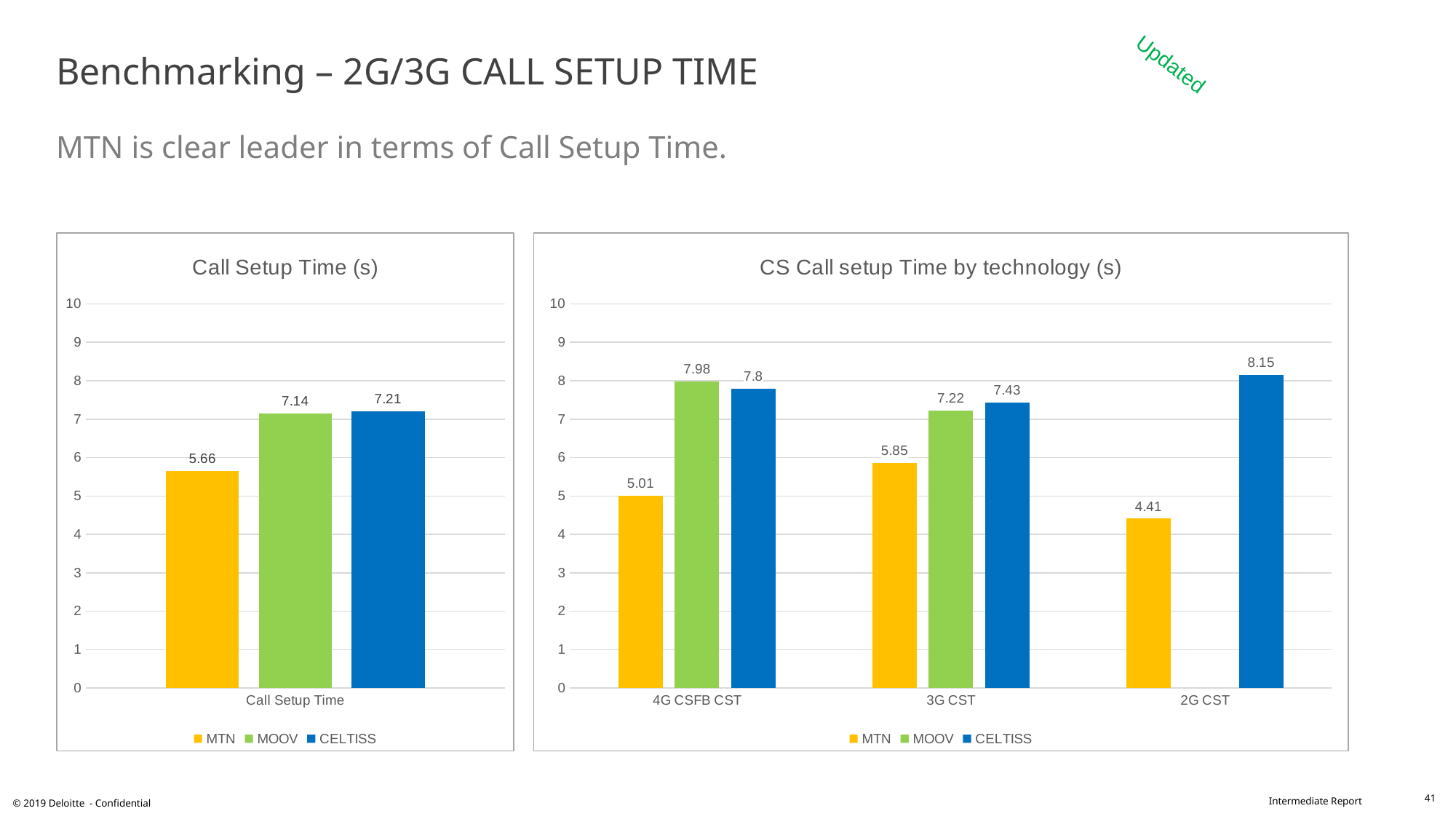
In the 'Call Setup Time (s)' chart, what is the value for MTN? 5.66 In the 'Call Setup Time (s)' chart, which operator has the lowest call setup time? MTN In the 'CS Call setup Time by technology (s)' chart, what is the value for CELTISS at 2G CST? 8.15 In the 'CS Call setup Time by technology (s)' chart, how many technology categories are shown on the x axis? 3 In the 'CS Call setup Time by technology (s)' chart, what is the difference between CELTISS and MTN at 3G CST? 1.58 In the 'Call Setup Time (s)' chart, what is the difference between CELTISS and MOOV? 0.07 In the 'CS Call setup Time by technology (s)' chart, which is larger at 4G CSFB CST: MOOV or CELTISS? MOOV In the 'Call Setup Time (s)' chart, how many series does the legend list? 3 What type of chart is the 'CS Call setup Time by technology (s)' chart? Bar chart In the 'CS Call setup Time by technology (s)' chart, what is the value for MOOV at 4G CSFB CST? 7.98 In the 'CS Call setup Time by technology (s)' chart, which bar has the lowest value? MTN at 2G CST In the 'CS Call setup Time by technology (s)' chart, which bar has the highest value? CELTISS at 2G CST